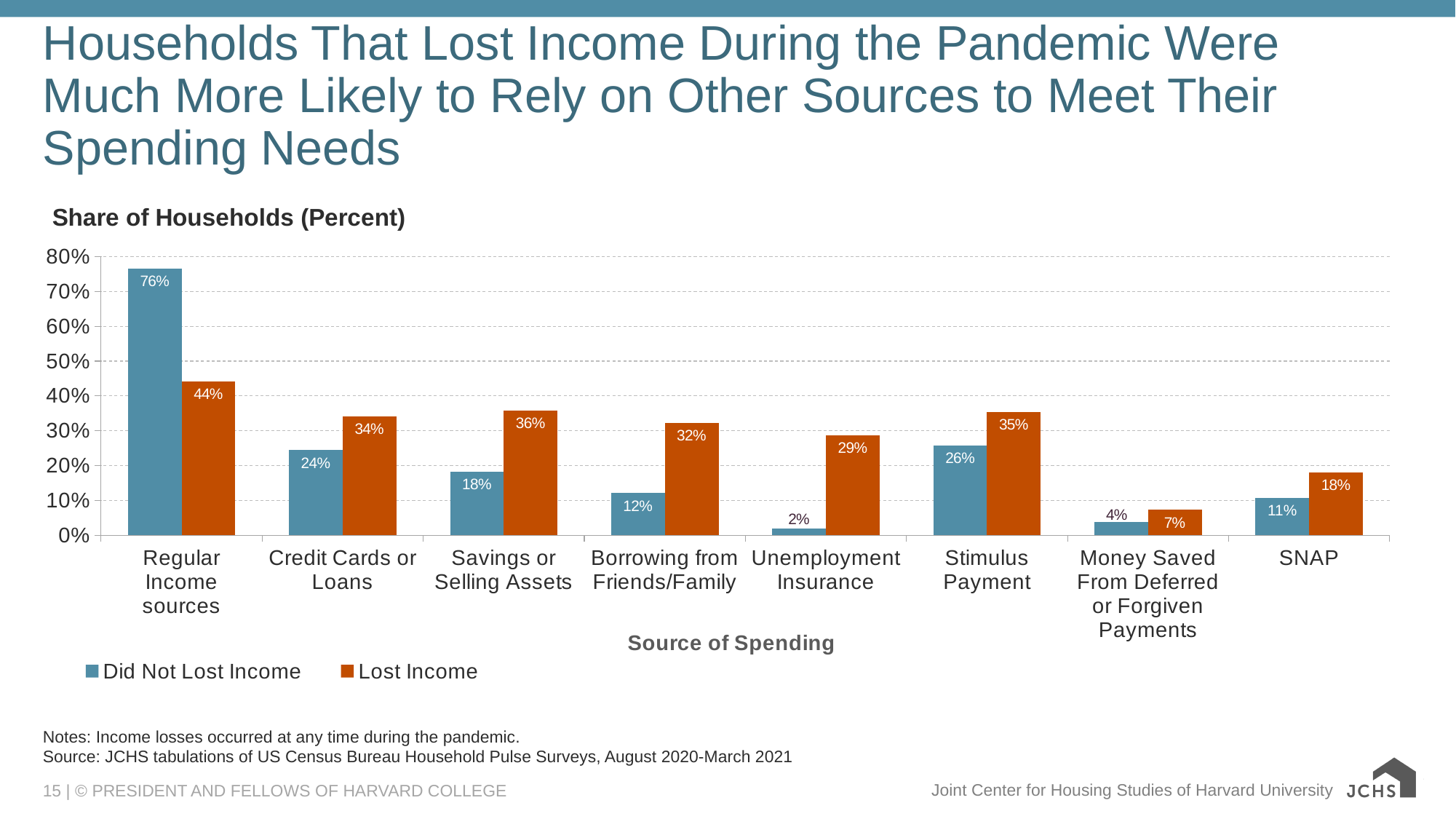
Is the Lost Income value for Credit Cards or Loans greater or less than 30%? greater For Stimulus Payment, which series has the larger value: Did Not Lost Income or Lost Income? Lost Income How many sources of spending are shown on the x axis? 8 Which source of spending has the lowest value for the Did Not Lost Income series? Unemployment Insurance What is the value for Lost Income households for SNAP? 18% What is the difference between the Lost Income and Did Not Lost Income values for Borrowing from Friends/Family? 20 percentage points What is the value for Lost Income households for Unemployment Insurance? 29% What kind of chart is shown on the slide? Bar chart How many series does the legend list? 2 Which source of spending has the highest value for the Lost Income series? Regular Income sources What is the value for Did Not Lost Income households for Regular Income sources? 76% What is the label of the x axis? Source of Spending